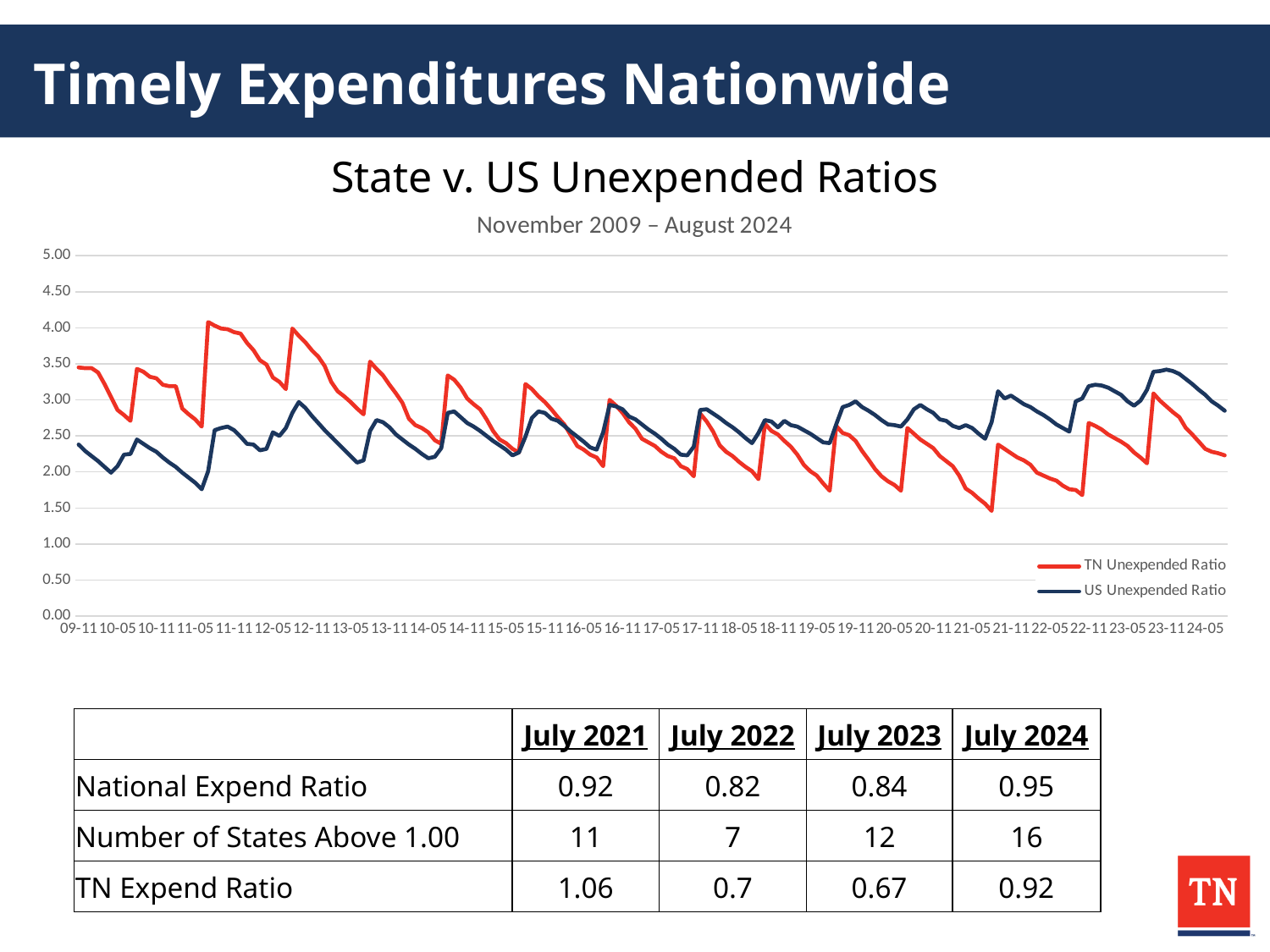
At 23-05, which series has the higher value, TN Unexpended Ratio or US Unexpended Ratio? US Unexpended Ratio What is the highest value shown on the chart's vertical axis? 5.00 Is the US Unexpended Ratio at 11-05 greater or less than 2.00? less At 11-11, which series has the higher value, TN Unexpended Ratio or US Unexpended Ratio? TN Unexpended Ratio How many series does the chart legend list? 2 What is the title of the chart? State v. US Unexpended Ratios What kind of chart is shown on the slide? line chart Does the TN Unexpended Ratio line generally rise or fall from the start of the chart to the end? fall Is the TN Unexpended Ratio at 09-11 greater or less than 3.00? greater Is the TN Unexpended Ratio at 21-05 greater or less than 2.00? less What time period does the chart subtitle give? November 2009 – August 2024